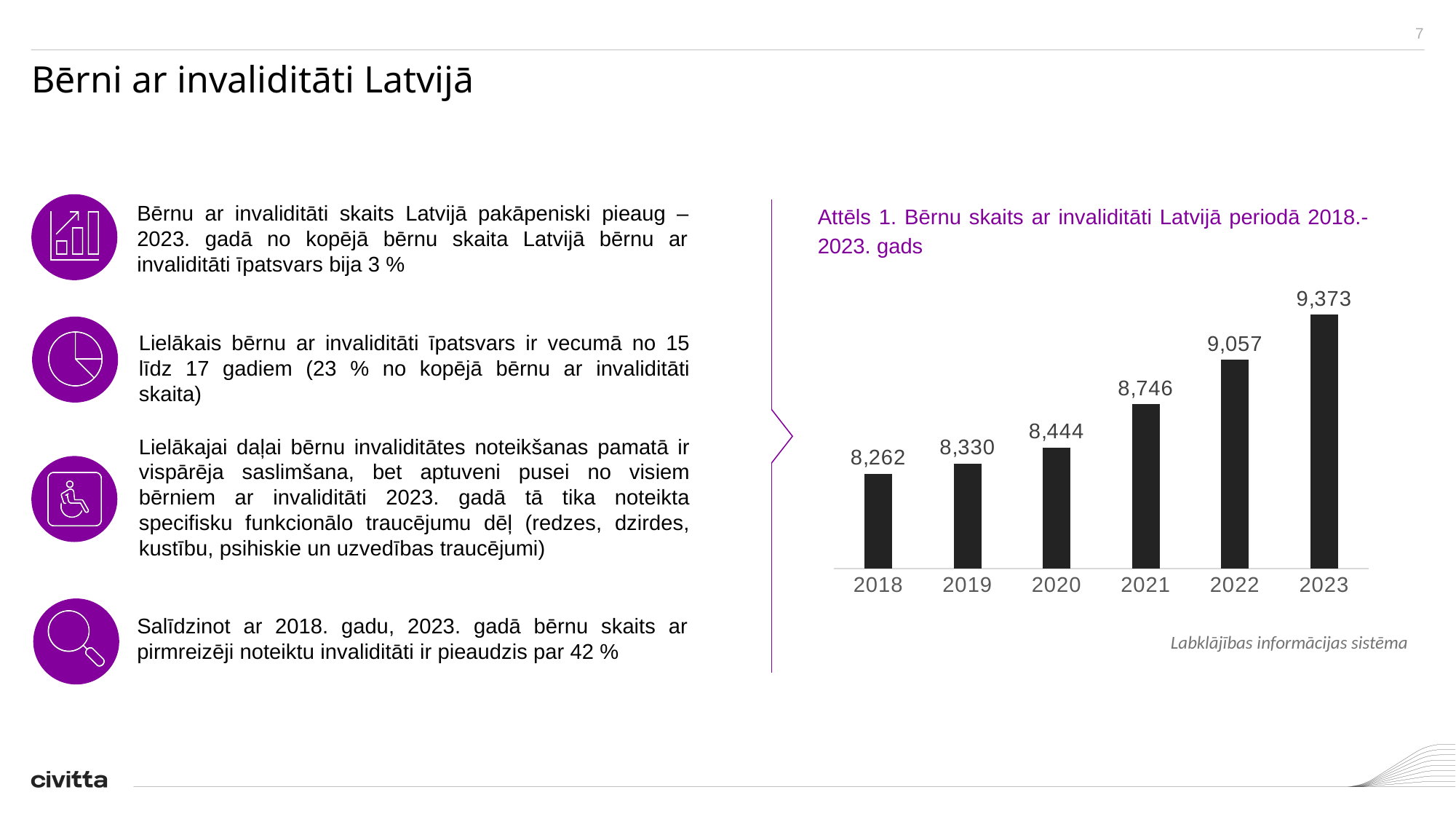
What value does the chart show for 2023? 9,373 What is the number of children with disabilities in Latvia in 2021 according to the chart? 8,746 Which year has the highest value in the chart? 2023 What is the difference between the values for 2023 and 2018? 1,111 What value does the chart show for 2018? 8,262 What is the source cited below the chart? Labklājības informācijas sistēma How many years are shown on the x axis of the chart? 6 What kind of chart is shown on the slide? Bar chart What is the difference between the values for 2022 and 2021? 311 Which year has the lowest value in the chart? 2018 Which is larger, the value for 2020 or the value for 2019? 2020 Do the values rise or fall from 2018 to 2023? Rise